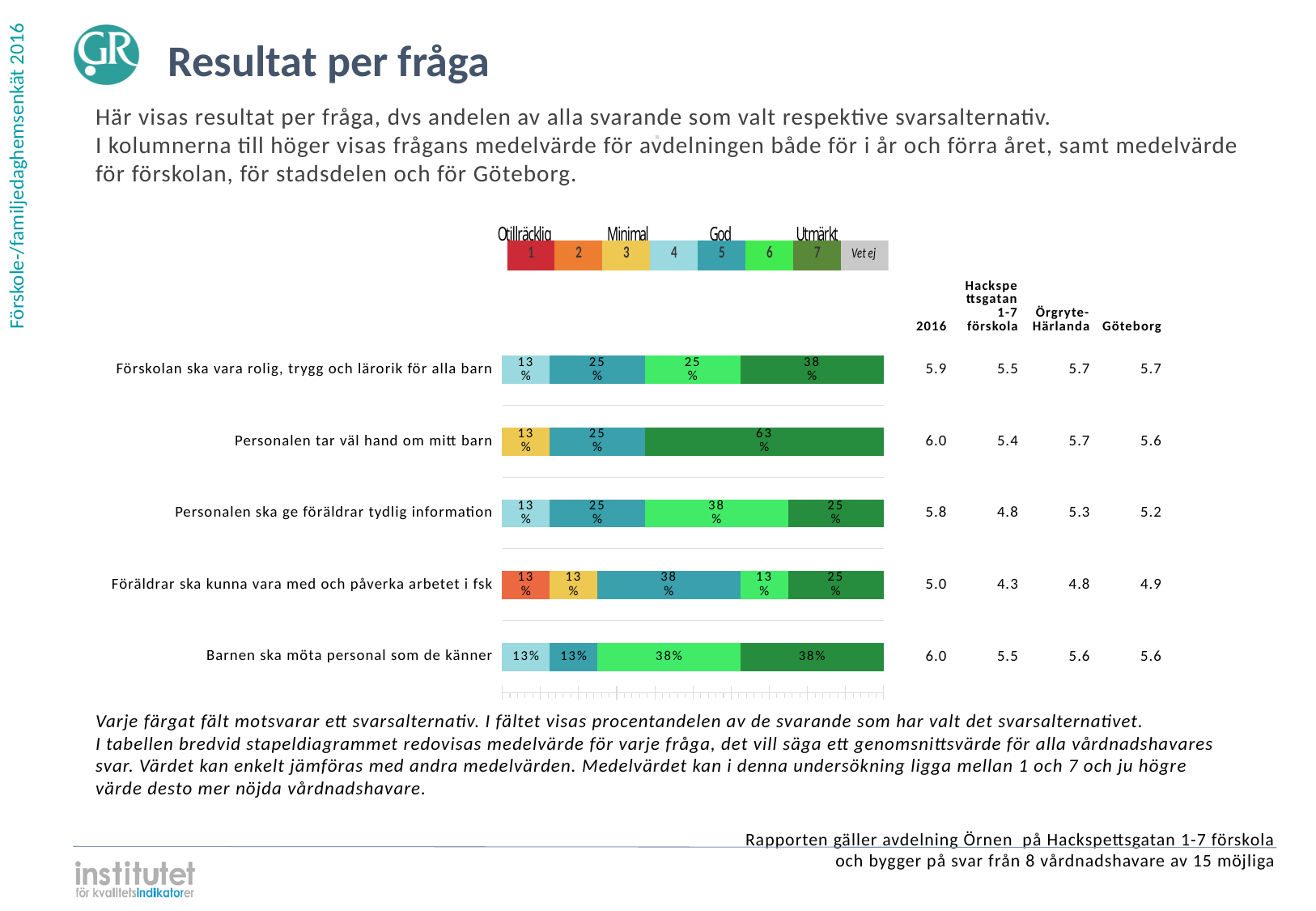
What is the difference between the answer 7 share for 'Personalen tar väl hand om mitt barn' (63%) and for 'Personalen ska ge föräldrar tydlig information' (25%)? 38% What percentage of respondents chose answer 7 (dark green) for 'Förskolan ska vara rolig, trygg och lärorik för alla barn'? 38% Which is larger: the answer 6 (bright green) share for 'Personalen ska ge föräldrar tydlig information' or for 'Förskolan ska vara rolig, trygg och lärorik för alla barn'? Personalen ska ge föräldrar tydlig information Which question is the only one with an answer 2 (orange) segment? Föräldrar ska kunna vara med och påverka arbetet i fsk How many entries does the legend above the chart list? 8 Which question has the largest share of respondents choosing answer 7 (dark green)? Personalen tar väl hand om mitt barn What kind of chart is shown on the slide? Stacked bar chart What percentage of respondents chose answer 7 (dark green) for 'Personalen tar väl hand om mitt barn'? 63% What is the 2016 mean value shown for 'Personalen ska ge föräldrar tydlig information'? 5.8 What percentage of respondents chose answer 5 (teal) for 'Föräldrar ska kunna vara med och påverka arbetet i fsk'? 38% Which question has the smallest share of respondents choosing answer 7 (dark green)? Personalen ska ge föräldrar tydlig information and Föräldrar ska kunna vara med och påverka arbetet i fsk (both 25%) How many questions (categories) are plotted in the bar chart? 5